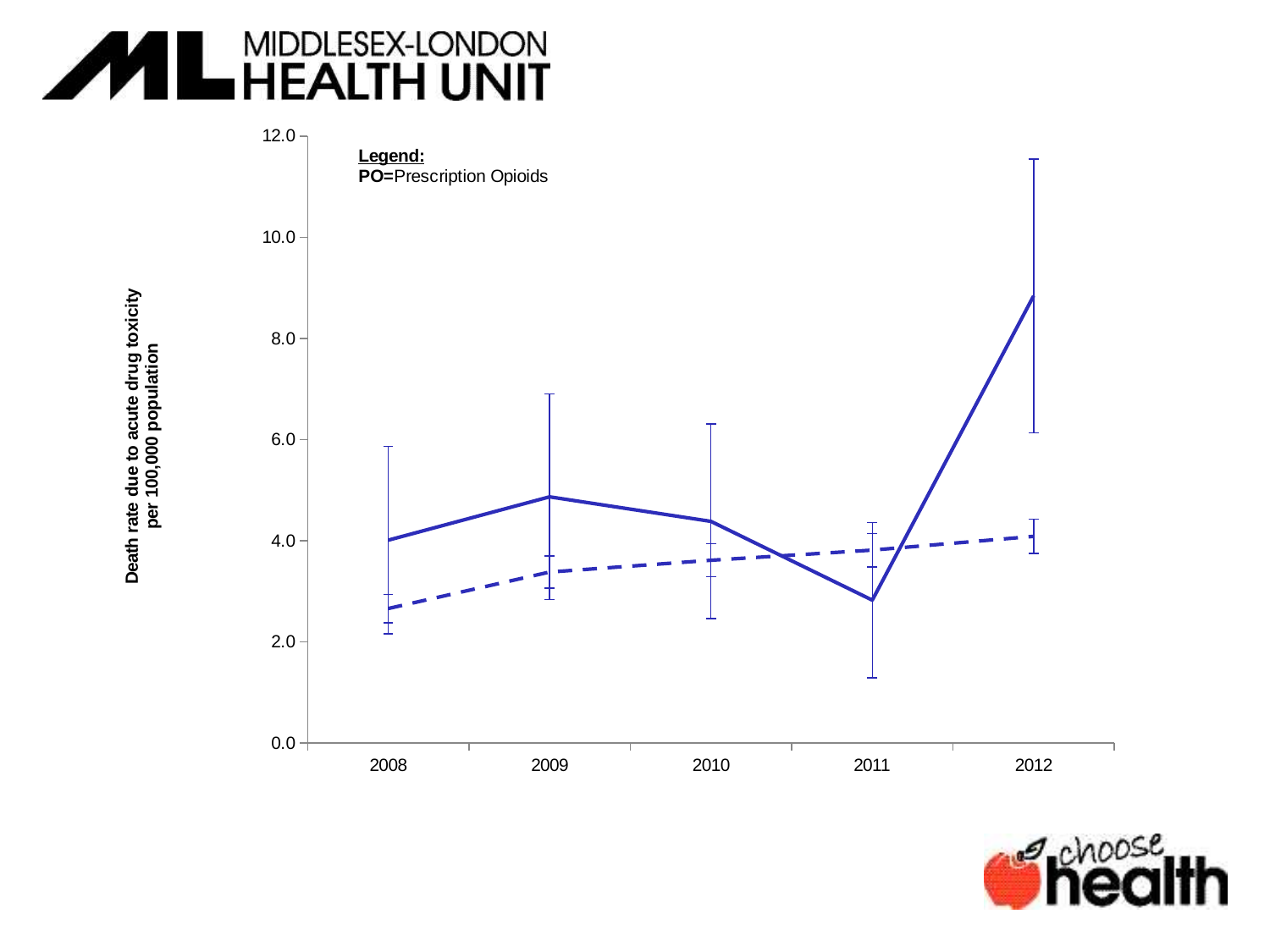
Does the dashed line rise or fall from 2008 to 2012? rise In 2012, which line has the higher value, the solid line or the dashed line? the solid line What is the label of the y axis? Death rate due to acute drug toxicity per 100,000 population In which year does the solid line reach its lowest value? 2011 What kind of chart is shown on the slide? line chart Is the value of the dashed line in 2008 greater or less than 4.0? less Is the value of the solid line in 2011 greater or less than 4.0? less Is the value of the dashed line in 2012 greater or less than 6.0? less How many lines are plotted on the chart? 2 How many years are shown along the x axis of the chart? 5 In which year does the solid line reach its highest value? 2012